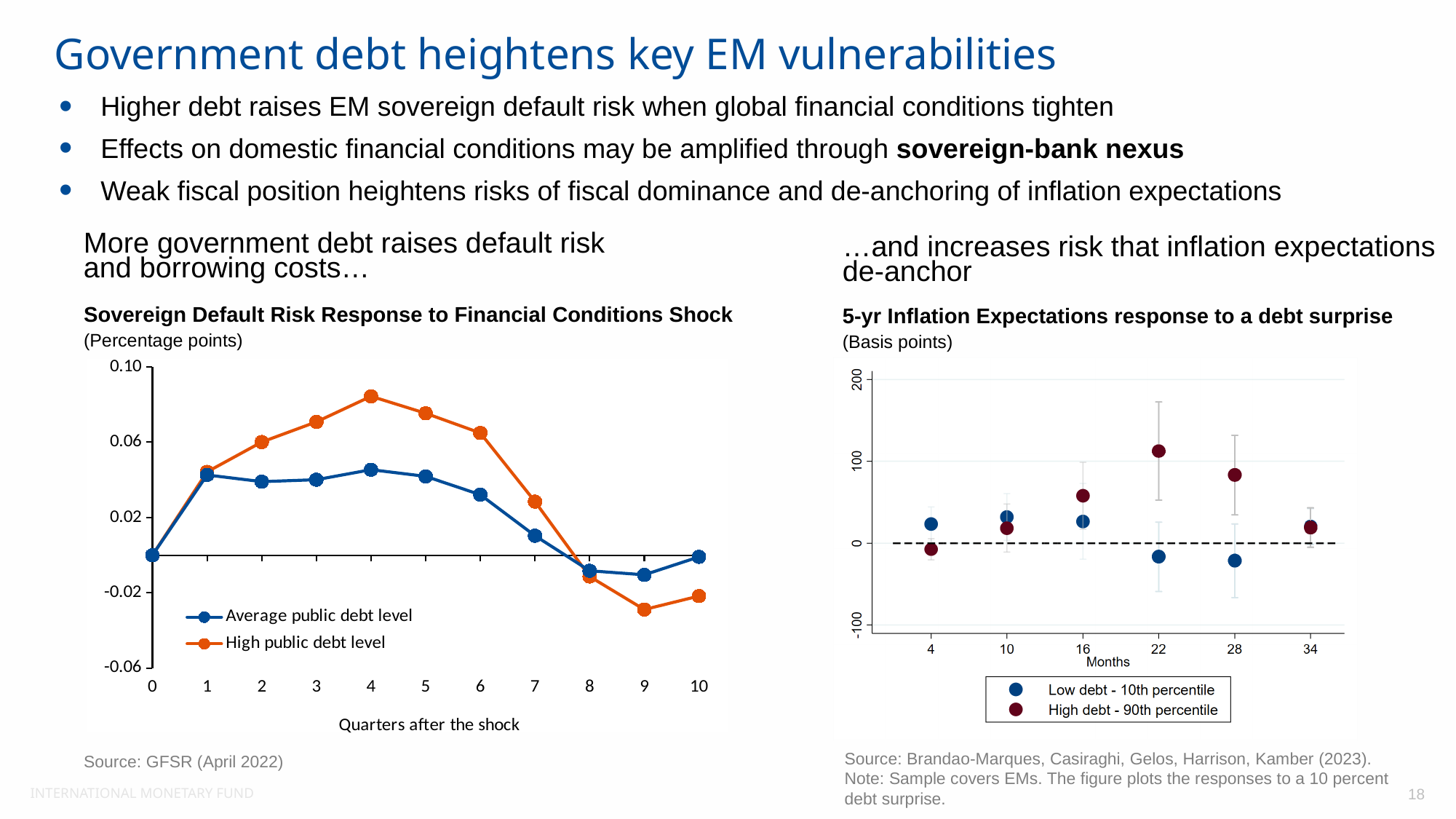
In the 'Sovereign Default Risk Response to Financial Conditions Shock' chart, at which quarter does the High public debt level series reach its highest value? 4 In the '5-yr Inflation Expectations response to a debt surprise' chart, is the High debt - 90th percentile value at 22 months greater or less than 100? greater In the '5-yr Inflation Expectations response to a debt surprise' chart, at how many month horizons are points plotted? 6 In the '5-yr Inflation Expectations response to a debt surprise' chart, at which month horizon is the High debt - 90th percentile value highest? 22 In the 'Sovereign Default Risk Response to Financial Conditions Shock' chart, is the High public debt level value at quarter 4 greater or less than 0.06? greater What is the x-axis label of the 'Sovereign Default Risk Response to Financial Conditions Shock' chart? Quarters after the shock In the '5-yr Inflation Expectations response to a debt surprise' chart, how many series does the legend list? 2 What kind of chart is the 'Sovereign Default Risk Response to Financial Conditions Shock' chart? Line chart In the 'Sovereign Default Risk Response to Financial Conditions Shock' chart, how many quarters are plotted on the x axis? 11 In the 'Sovereign Default Risk Response to Financial Conditions Shock' chart, does the High public debt level series rise or fall between quarter 4 and quarter 9? Fall In the 'Sovereign Default Risk Response to Financial Conditions Shock' chart, which series has the larger value at quarter 4? High public debt level How many series does the legend of the 'Sovereign Default Risk Response to Financial Conditions Shock' chart list? 2